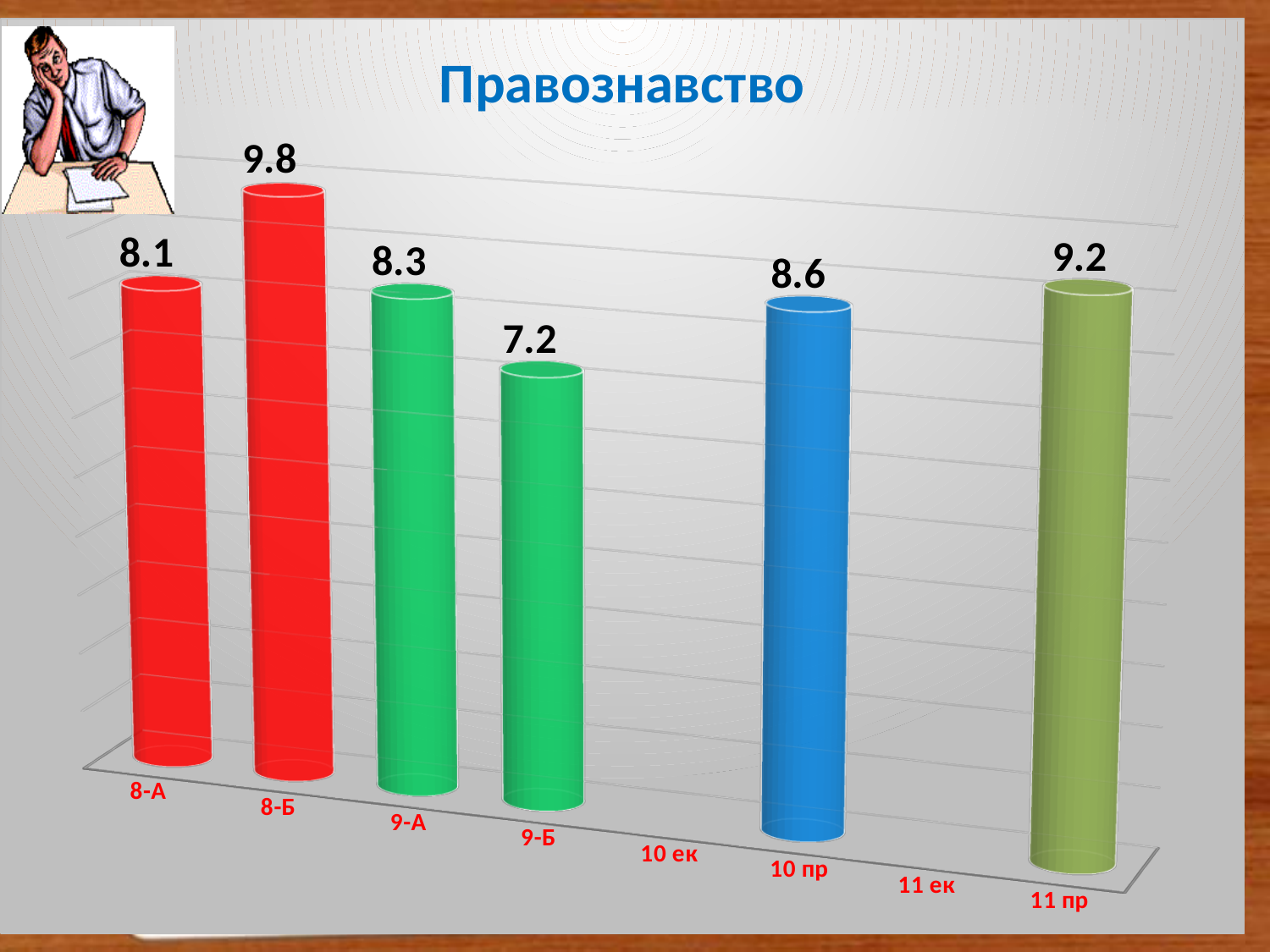
How many category labels are shown along the x axis? 8 What is the value for 8-Б? 9.8 Which is larger, the value for 9-А or the value for 8-А? 9-А What is the value for 10 пр? 8.6 What is the difference between the values for 11 пр and 10 пр? 0.6 Which category has the highest value? 8-Б What is the title of the chart? Правознавство What is the difference between the values for 8-Б and 9-Б? 2.6 Which category has the lowest value among the plotted bars? 9-Б What is the value for 9-Б? 7.2 What is the value for 11 пр? 9.2 What type of chart is shown on the slide? bar chart